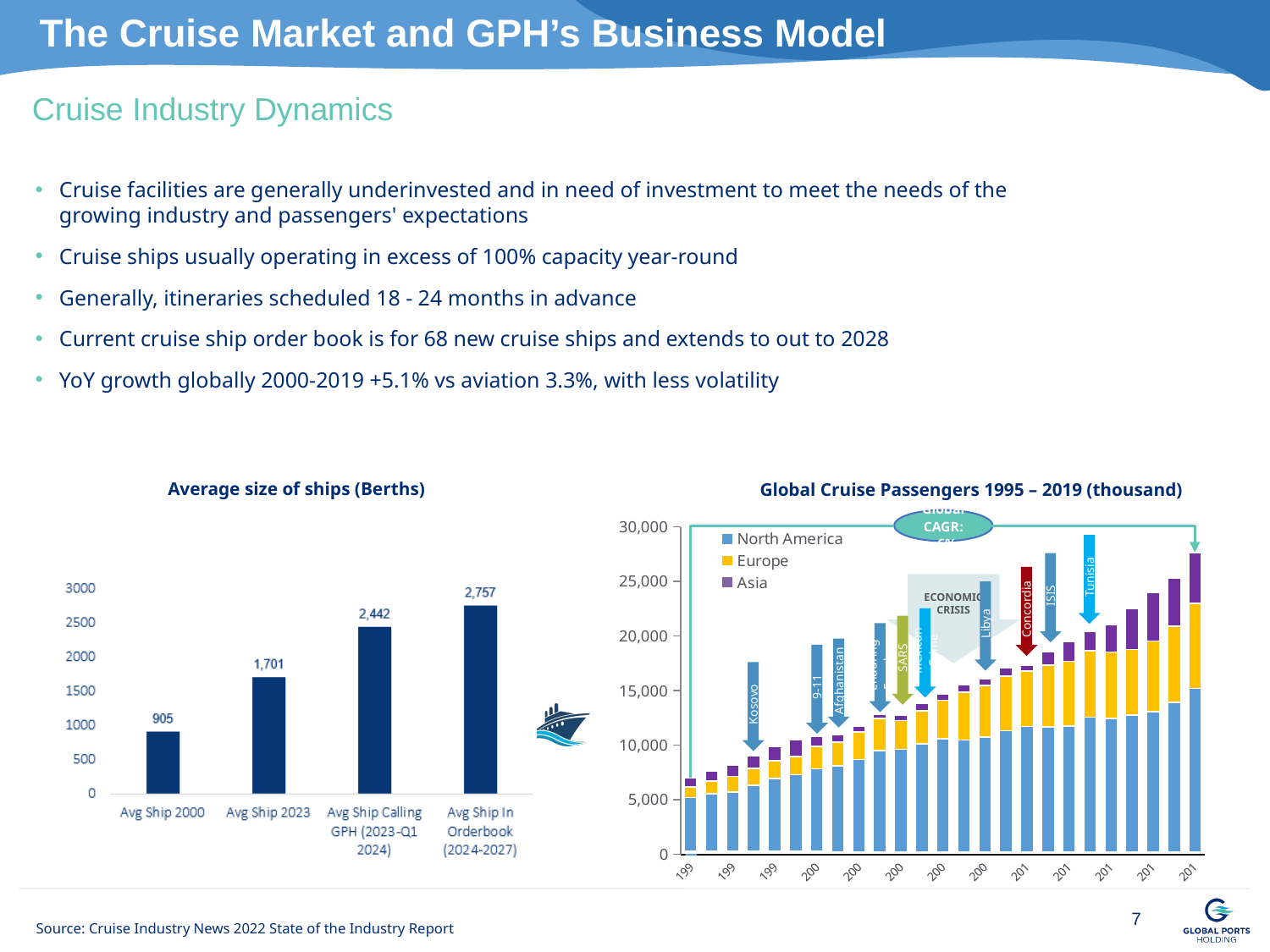
In the 'Average size of ships (Berths)' chart, what is the value for Avg Ship 2000? 905 What kind of chart is the 'Average size of ships (Berths)' chart? Bar chart How many series does the legend of the 'Global Cruise Passengers 1995 – 2019 (thousand)' chart list? 3 How many categories are shown in the 'Average size of ships (Berths)' chart? 4 In the 'Global Cruise Passengers 1995 – 2019 (thousand)' chart, do the total bar heights generally rise or fall from left to right? Rise In the 'Global Cruise Passengers 1995 – 2019 (thousand)' chart, which series is shown in yellow? Europe In the 'Average size of ships (Berths)' chart, which category has the highest value? Avg Ship In Orderbook (2024-2027) In the 'Average size of ships (Berths)' chart, what is the difference between Avg Ship In Orderbook (2024-2027) and Avg Ship 2023? 1,056 In the 'Average size of ships (Berths)' chart, what is the value for Avg Ship Calling GPH (2023-Q1 2024)? 2,442 In the 'Average size of ships (Berths)' chart, which category has the lowest value? Avg Ship 2000 In the 'Average size of ships (Berths)' chart, which is larger: Avg Ship Calling GPH (2023-Q1 2024) or Avg Ship 2023? Avg Ship Calling GPH (2023-Q1 2024) In the 'Average size of ships (Berths)' chart, what is the value for Avg Ship 2023? 1,701